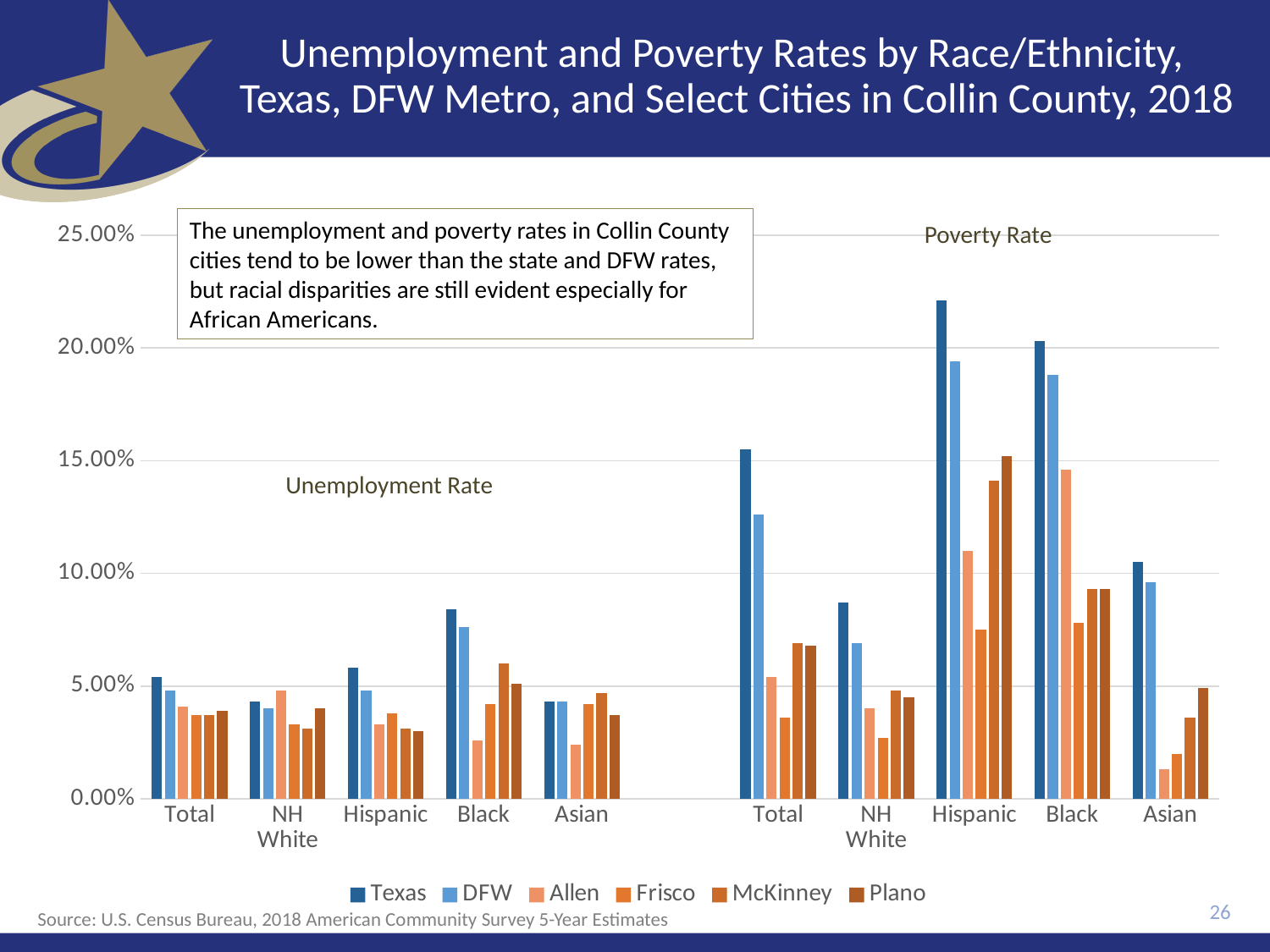
What kind of chart is shown on the slide? bar chart How many series does the legend list? 6 In the Poverty Rate group, which is larger for the Total category: Texas or DFW? Texas How many race/ethnicity categories are shown in the Poverty Rate group? 5 In the Poverty Rate group, is the value for Texas in the Hispanic category greater or less than 20.00%? greater In the Poverty Rate group, which series has the lowest value for the Asian category? Allen In the Unemployment Rate group, is the value for Texas in the Black category greater or less than 10.00%? less In the Poverty Rate group, is the value for DFW in the Total category greater or less than 10.00%? greater Which series is listed first in the legend? Texas In the Unemployment Rate group, which series has the lowest value for the Black category? Allen In the Poverty Rate group, which series has the highest value for the Hispanic category? Texas In the Unemployment Rate group, which is larger for the Black category: Allen or McKinney? McKinney